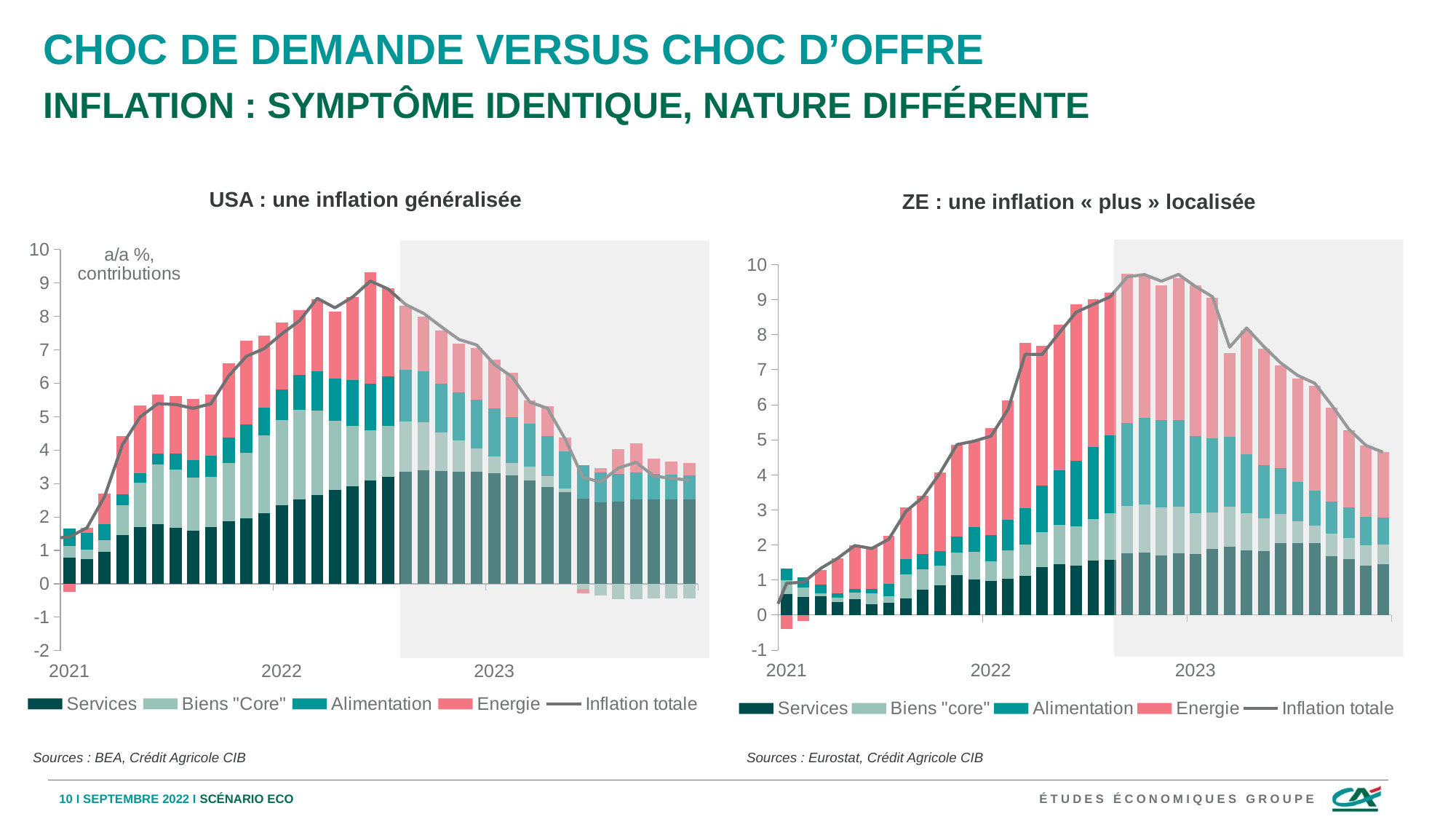
What kind of chart is the 'USA : une inflation généralisée' chart? bar chart (stacked, with a line) In the 'ZE : une inflation « plus » localisée' chart, does Inflation totale rise or fall over the course of 2023? fall In the 'USA : une inflation généralisée' chart, which series is drawn as a line rather than as bars? Inflation totale In the 'ZE : une inflation « plus » localisée' chart, is the peak value of Inflation totale greater or less than 9? greater In the 'USA : une inflation généralisée' chart, is the contribution of Biens "Core" at the end of 2023 greater or less than 0? less How many series does the legend of the 'USA : une inflation généralisée' chart list? 5 In the 'USA : une inflation généralisée' chart, is the peak value of Inflation totale greater or less than 8? greater How many series does the legend of the 'ZE : une inflation « plus » localisée' chart list? 5 In the 'USA : une inflation généralisée' chart, does Inflation totale rise or fall from the start of 2021 to mid-2022? rise In the 'ZE : une inflation « plus » localisée' chart, which series is the largest contributor at the peak of inflation? Energie